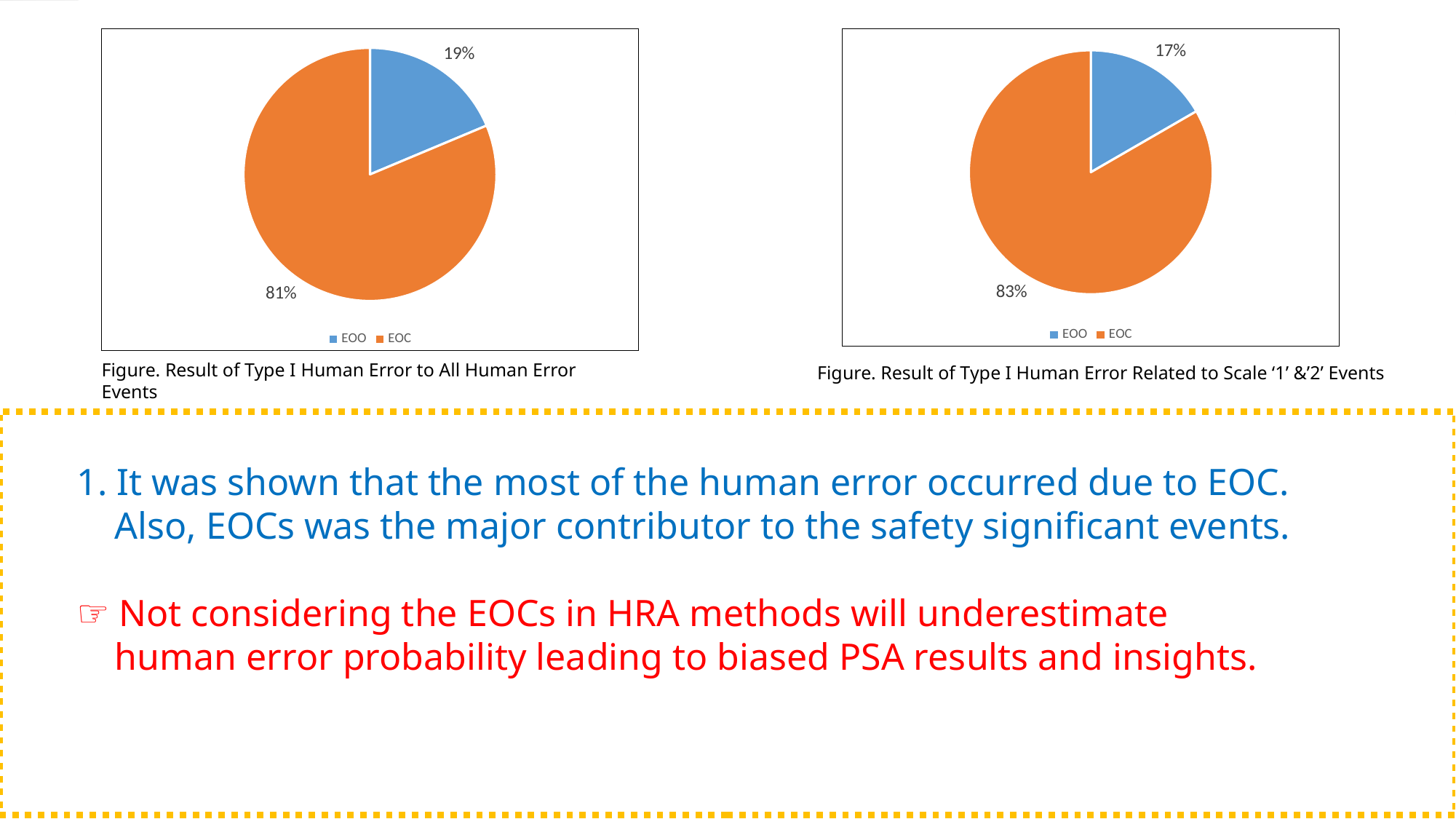
In the right pie chart, what is the difference in percentage points between EOC and EOO? 66 In the left pie chart (Type I Human Error to All Human Error Events), what share does EOO have? 19% In the left pie chart, what is the difference in percentage points between EOC and EOO? 62 In the left pie chart, what colour is the EOO slice? Blue In the right pie chart, which category has the smallest slice? EOO How many categories does the left pie chart show? 2 In the right pie chart (Type I Human Error Related to Scale '1' & '2' Events), what share does EOC have? 83% In the right pie chart (Type I Human Error Related to Scale '1' & '2' Events), what share does EOO have? 17% In the right pie chart, which is larger, EOO or EOC? EOC What type of chart is shown on the right side of the slide? Pie chart In the left pie chart, which category has the largest slice? EOC